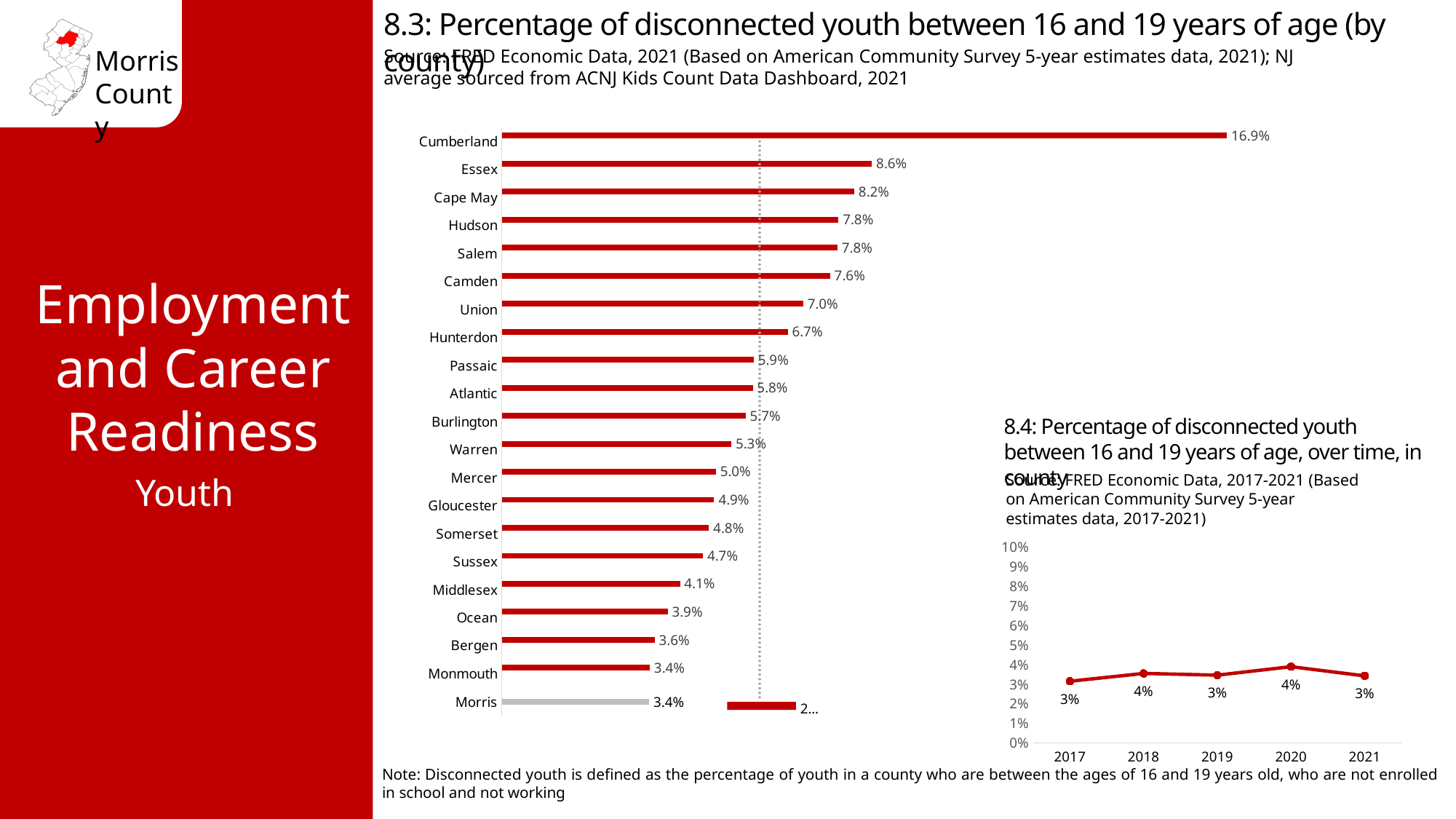
In chart 8.3, which county has the highest percentage of disconnected youth? Cumberland In chart 8.3, what is the difference between the values for Essex and Cape May? 0.4 percentage points In chart 8.3, which has a higher value, Hudson or Camden? Hudson In chart 8.4, what is the value for 2020? 4% In chart 8.4, does the value rise or fall from 2020 to 2021? Fall In chart 8.3, what is the difference between the values for Cumberland and Essex? 8.3 percentage points In chart 8.3, what colour is the bar for Morris? Grey In chart 8.3, what is the value shown for Morris? 3.4% In chart 8.3, what is the percentage of disconnected youth for Cumberland? 16.9% In chart 8.3, what is the value shown for Hunterdon? 6.7% In chart 8.4, how many years are plotted? 5 What kind of chart is chart 8.3? Bar chart